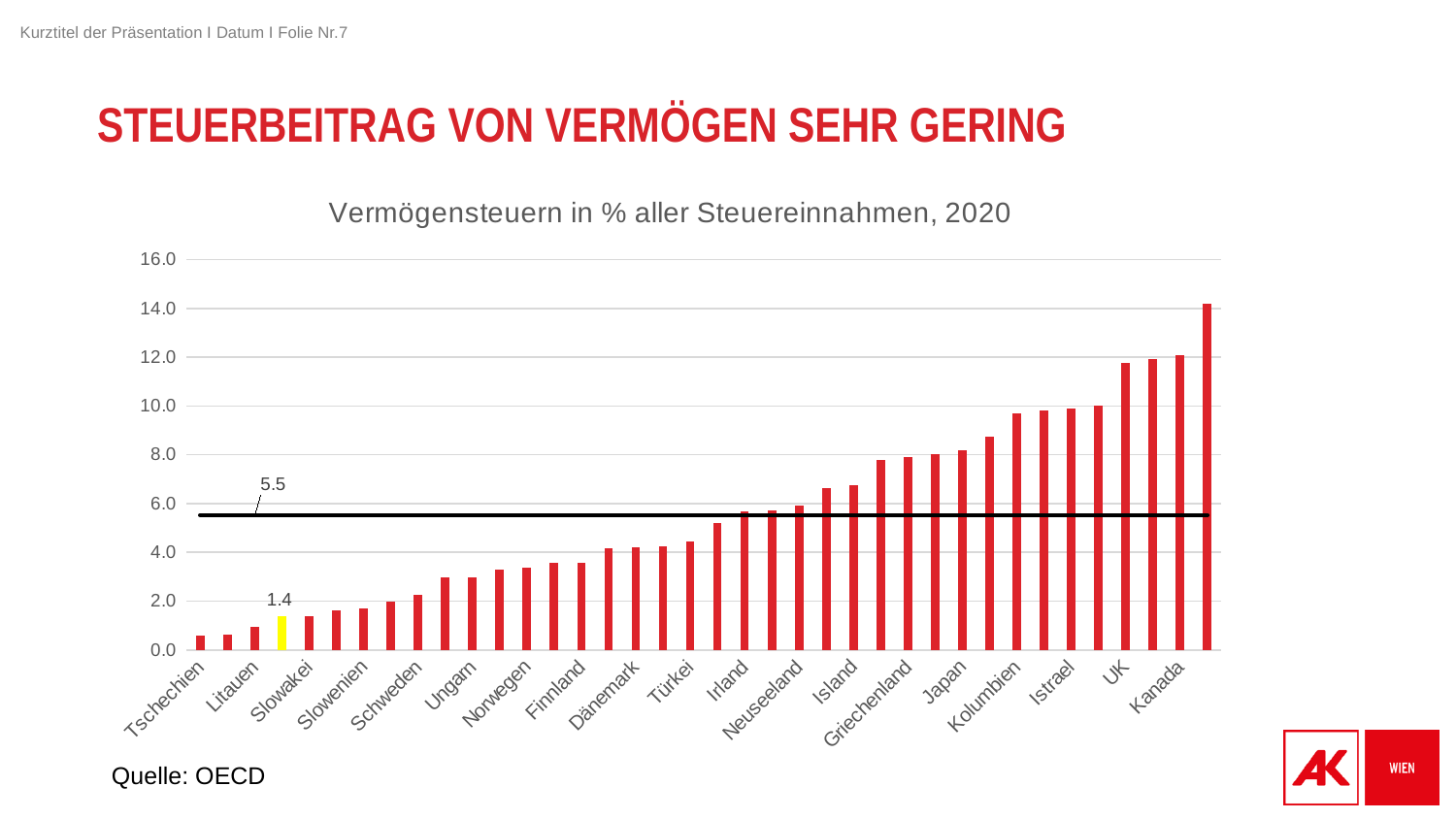
What kind of chart is shown on the slide? bar chart Is the value for Griechenland greater or less than 6.0? greater Do the bar values rise or fall from left to right along the x axis? rise What value is printed at the horizontal black line across the chart? 5.5 Is the value for Norwegen greater or less than 4.0? less Which has the larger value, UK or Japan? UK Is the value for UK greater or less than 10.0? greater What is the title of the chart? Vermögensteuern in % aller Steuereinnahmen, 2020 Which country has the lowest value in the chart? Tschechien What value is printed on the yellow highlighted bar? 1.4